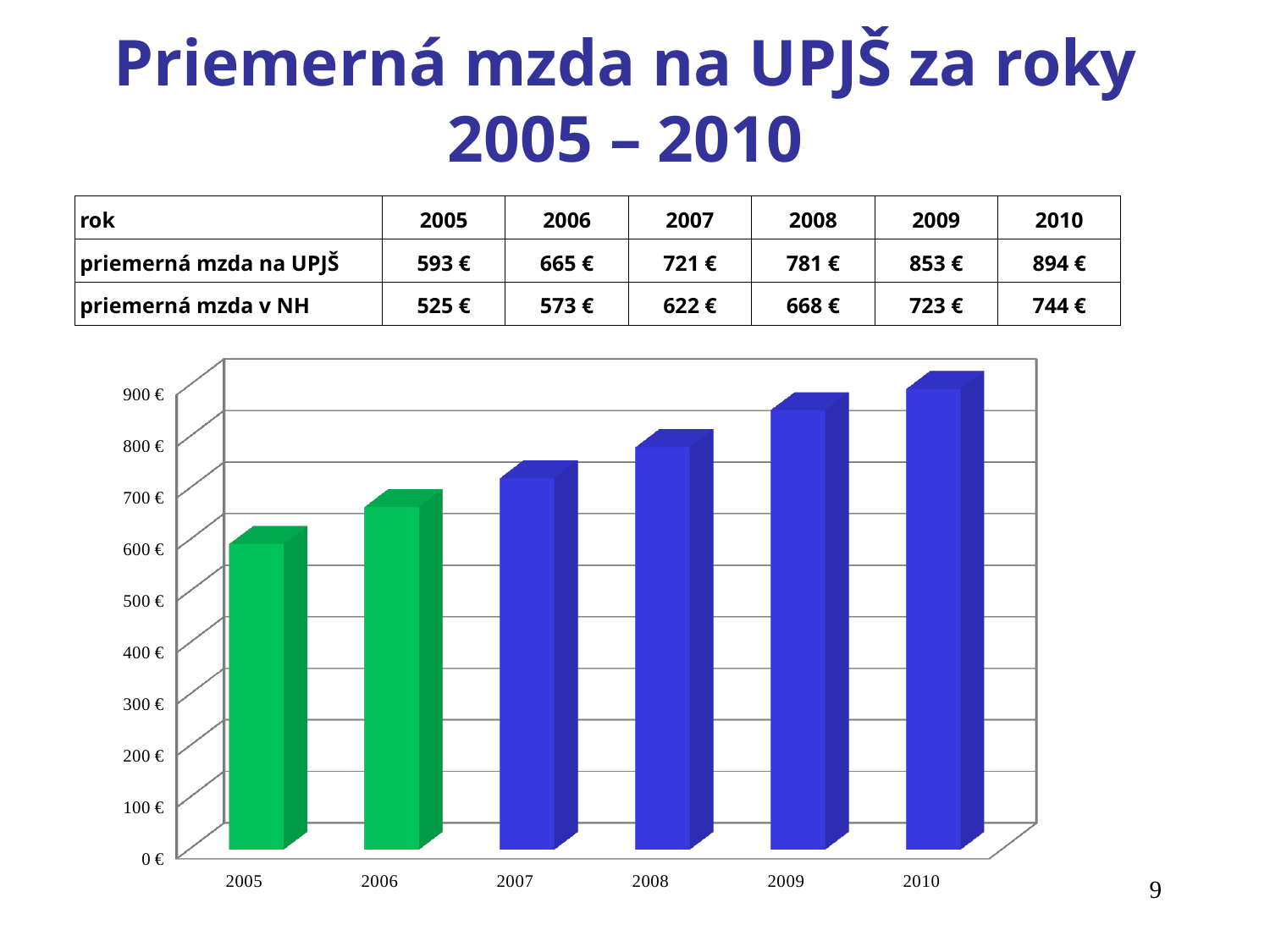
According to the table, what is the priemerná mzda na UPJŠ for 2010? 894 € Do the bar values rise or fall from 2005 to 2010? rise Is the value of the bar for 2009 greater or less than 800 €? greater According to the table, what is the difference between the priemerná mzda na UPJŠ and the priemerná mzda v NH in 2009? 130 € What kind of chart is shown on the slide? bar chart Which year has the highest bar in the chart? 2010 Is the value of the bar for 2008 greater or less than 800 €? less How many years (bars) does the chart show? 6 Which bars in the chart are coloured green? 2005 and 2006 According to the table, what is the priemerná mzda v NH for 2007? 622 € Which year has the lowest bar in the chart? 2005